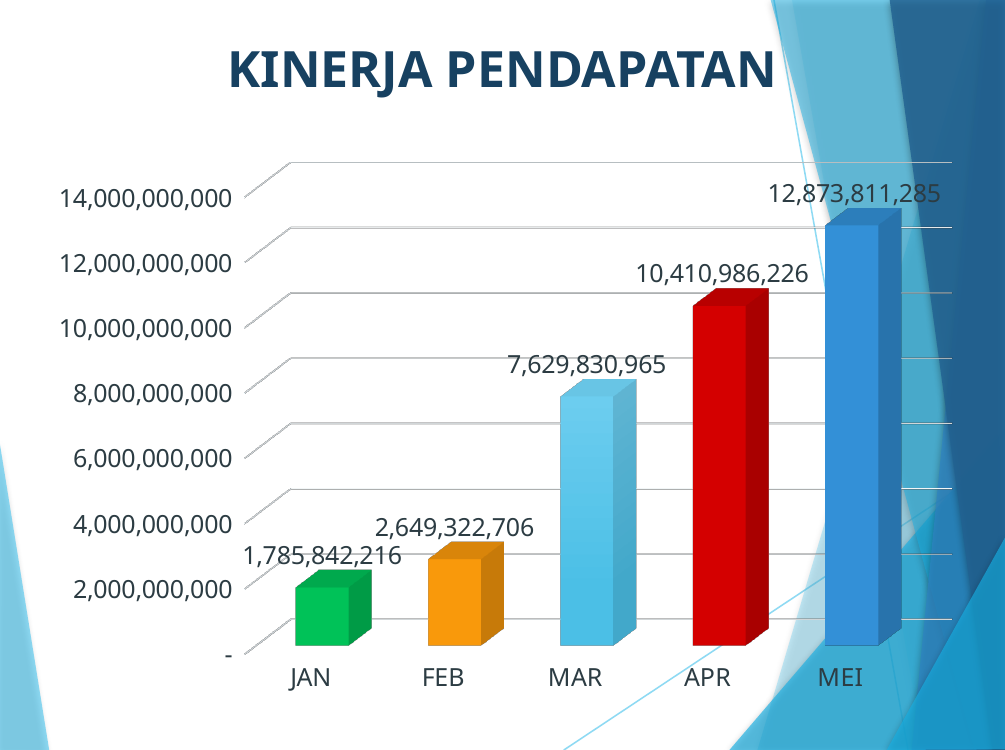
What is the difference between the values for MEI and APR? 2,462,825,059 Which month has the lowest value? JAN What kind of chart is shown on the slide? bar chart How many months are shown on the chart? 5 What is the value for MEI? 12,873,811,285 What is the value for JAN? 1,785,842,216 Which month has the highest value? MEI Which is larger, the value for APR or the value for MAR? APR Is the value for APR greater or less than 10,000,000,000? greater What is the value for MAR? 7,629,830,965 Do the values rise or fall from JAN to MEI? rise What is the difference between the values for FEB and JAN? 863,480,490